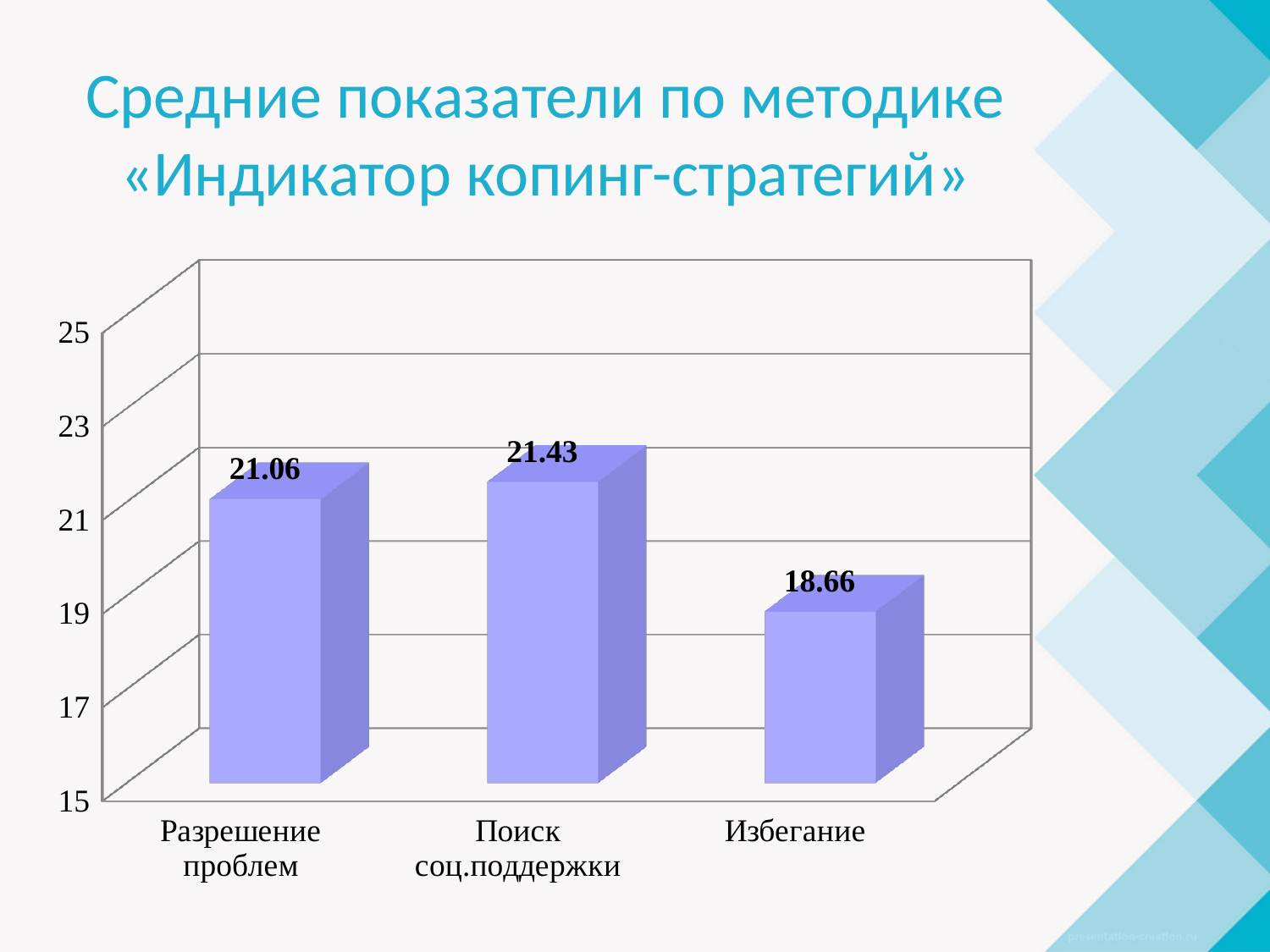
What is the value for Разрешение проблем? 21.06 Which category has the highest value? Поиск соц.поддержки Which is larger, the value for Разрешение проблем or the value for Избегание? Разрешение проблем What is the difference between the values for Разрешение проблем and Избегание? 2.40 Which category has the lowest value? Избегание What is the value for Избегание? 18.66 Is the value for Избегание greater or less than 19? less What is the title of the slide? Средние показатели по методике «Индикатор копинг-стратегий» How many categories are shown on the chart? 3 What is the value for Поиск соц.поддержки? 21.43 What kind of chart is shown on the slide? bar chart What is the difference between the values for Поиск соц.поддержки and Избегание? 2.77